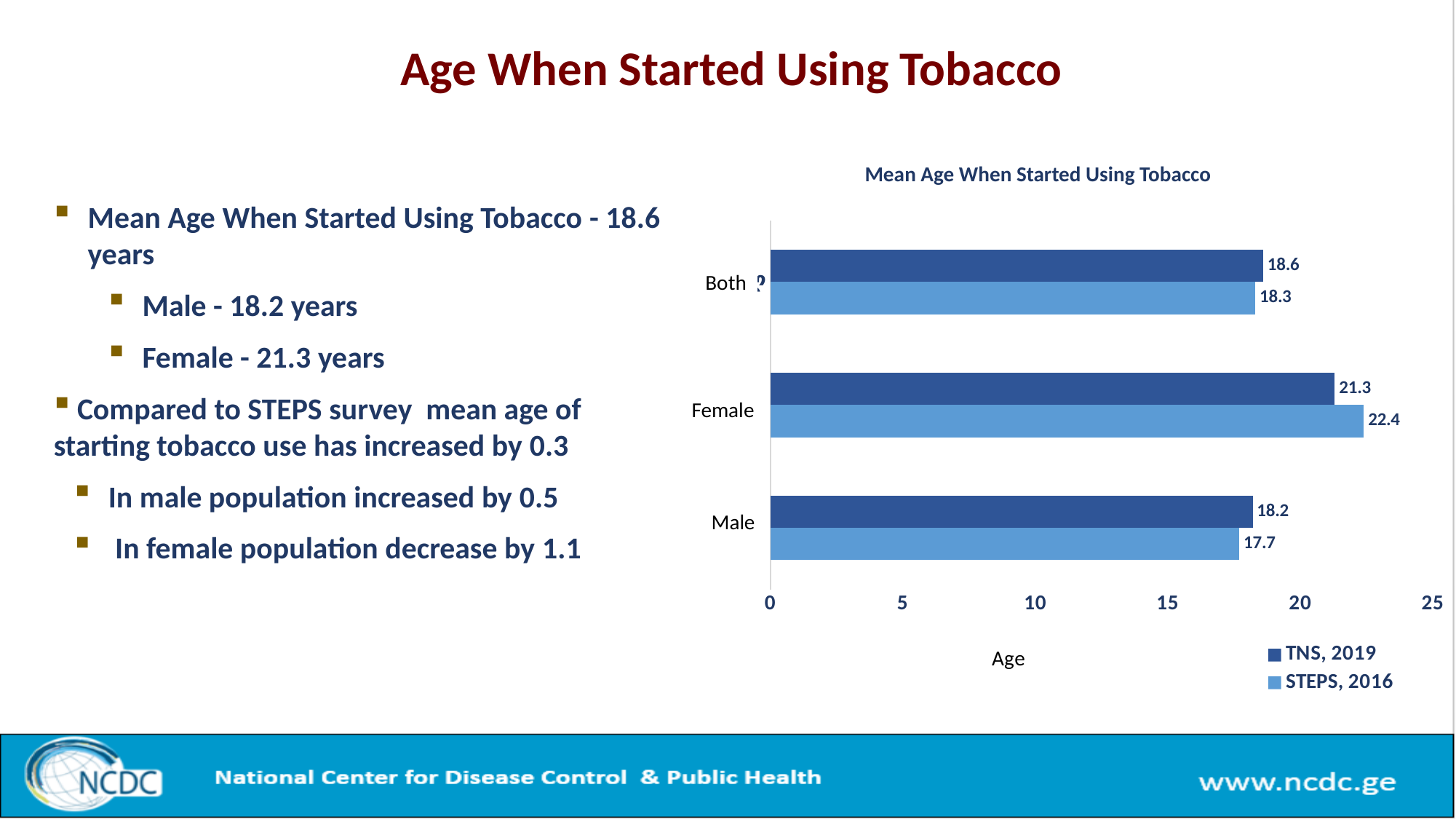
How many categories are shown on the y axis of the chart? 3 Is the STEPS, 2016 value for Female greater or less than 20? greater What is the STEPS, 2016 value for Both? 18.3 Which is larger for Both: the TNS, 2019 value or the STEPS, 2016 value? TNS, 2019 How many series does the chart legend list? 2 Which category has the lowest STEPS, 2016 value? Male Which category has the highest TNS, 2019 value? Female What is the difference between the STEPS, 2016 and TNS, 2019 values for Female? 1.1 What is the difference between the TNS, 2019 and STEPS, 2016 values for Male? 0.5 What kind of chart is shown on the slide? Bar chart What is the STEPS, 2016 mean age when started using tobacco for Male? 17.7 What is the TNS, 2019 mean age when started using tobacco for Female? 21.3